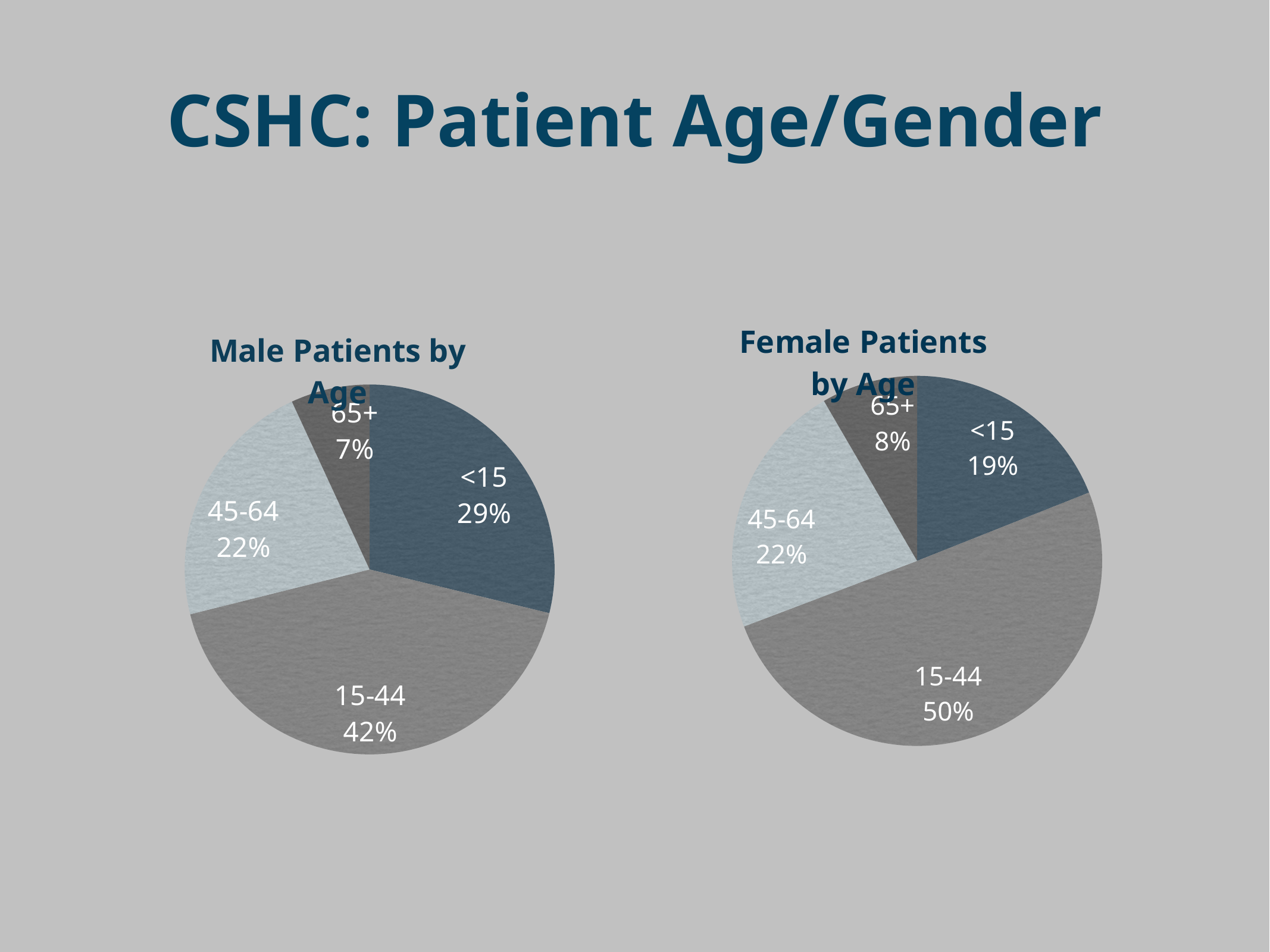
In the 'Male Patients by Age' chart, what percentage is shown for the <15 age group? 29% In the 'Male Patients by Age' chart, what share of patients are aged 15-44? 42% What is the title of the slide? CSHC: Patient Age/Gender In the 'Female Patients by Age' chart, what is the difference between the 15-44 share and the 45-64 share? 28% In the 'Female Patients by Age' chart, what percentage is shown for the 65+ age group? 8% What type of chart is 'Male Patients by Age'? Pie chart In the 'Male Patients by Age' chart, which age group has the largest share? 15-44 In the 'Female Patients by Age' chart, which age group has the smallest share? 65+ In the 'Male Patients by Age' chart, what is the difference between the <15 share and the 65+ share? 22% In the 'Female Patients by Age' chart, what share of patients are aged 15-44? 50% How many age groups are shown in the 'Female Patients by Age' chart? 4 Which chart shows a larger share for the <15 age group, 'Male Patients by Age' or 'Female Patients by Age'? Male Patients by Age